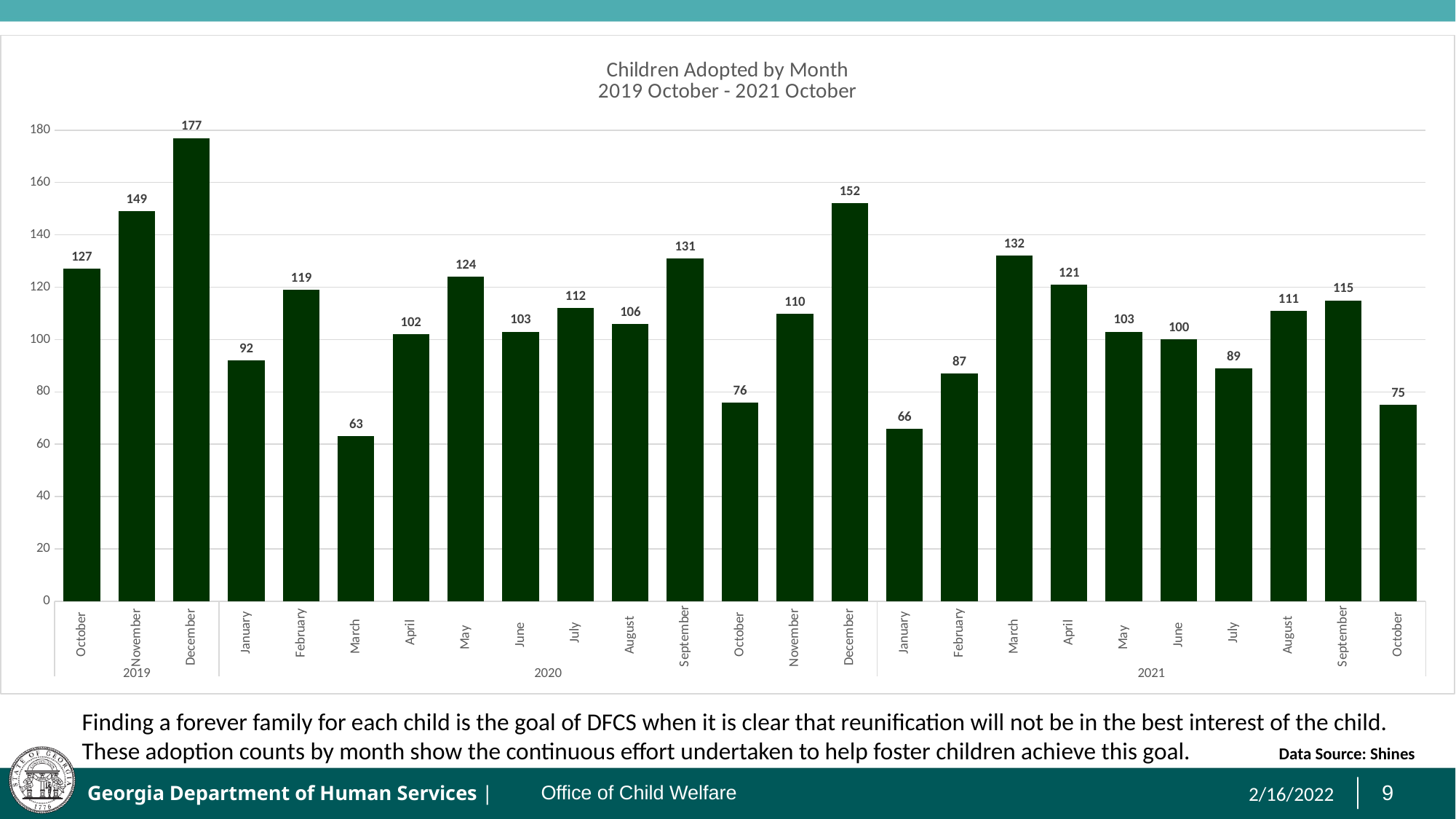
What is the difference between the values for December 2020 and January 2021? 86 What is the value for March 2021? 132 Which is larger, the value for September 2020 or the value for September 2021? September 2020 How many children were adopted in October 2021? 75 What is the title of the chart? Children Adopted by Month 2019 October - 2021 October How many monthly bars are shown in the chart? 25 Which month has the highest number of children adopted? December 2019 Which month has the lowest number of children adopted? March 2020 How many children were adopted in December 2019? 177 Do the values rise or fall from October 2019 to December 2019? rise What kind of chart is shown on the slide? bar chart Is the value for October 2020 greater or less than 80? less